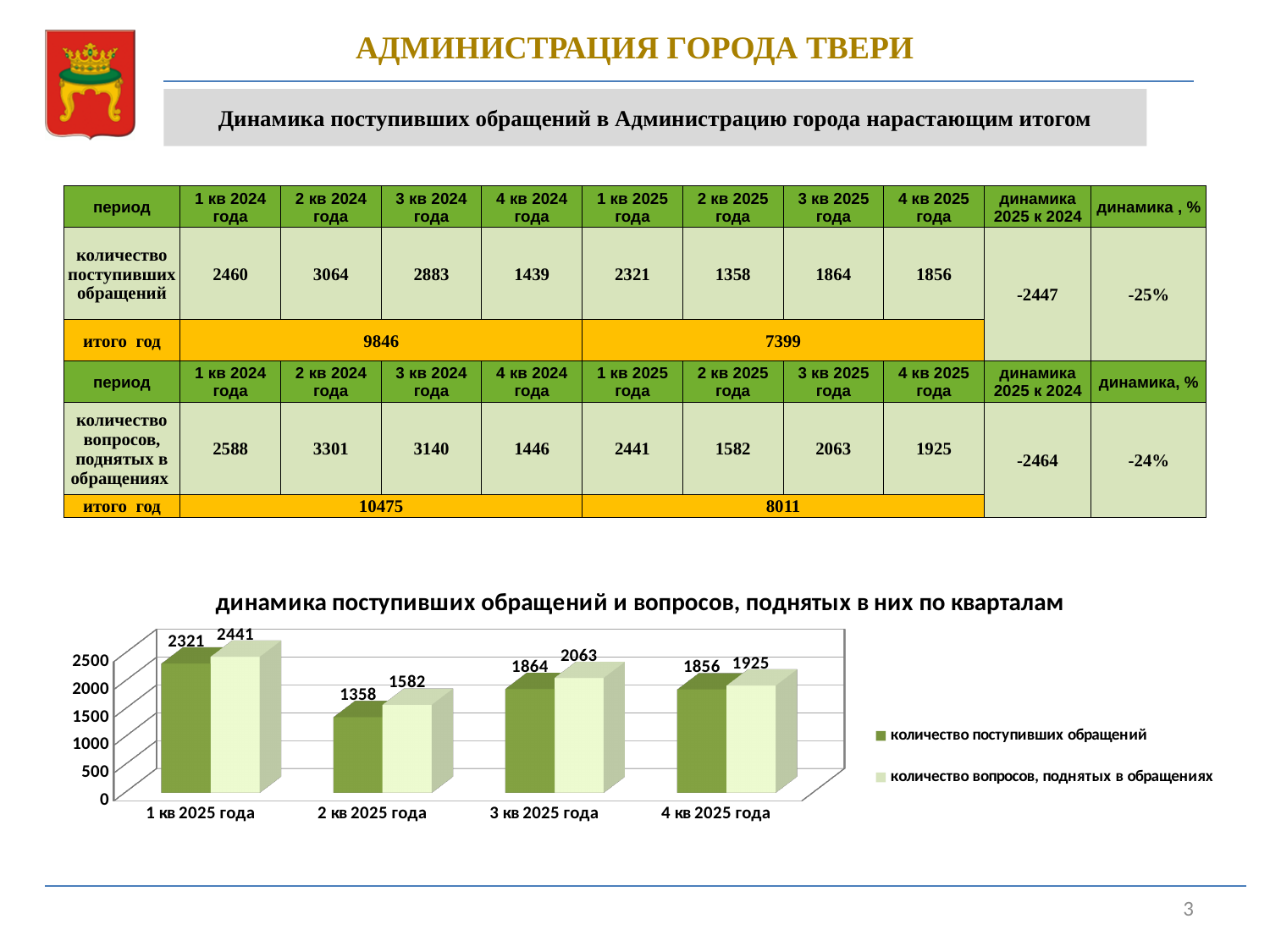
На сколько значение «количество вопросов, поднятых в обращениях» превышает «количество поступивших обращений» во 2 кв 2025 года на диаграмме? 224 В каком квартале значение серии «количество поступивших обращений» на диаграмме наибольшее? 1 кв 2025 года Что больше на диаграмме: «количество поступивших обращений» за 3 кв 2025 года или за 4 кв 2025 года? 3 кв 2025 года Какое значение показано для серии «количество поступивших обращений» за 4 кв 2025 года на диаграмме? 1856 Какого типа диаграмма на слайде? столбчатая (bar chart) Сколько серий перечислено в легенде диаграммы? 2 Какое значение показано для серии «количество поступивших обращений» за 1 кв 2025 года на диаграмме? 2321 В каком квартале значение серии «количество вопросов, поднятых в обращениях» на диаграмме наименьшее? 2 кв 2025 года Сколько кварталов показано по оси X на диаграмме? 4 Значение «количество поступивших обращений» за 2 кв 2025 года на диаграмме больше или меньше 1500? меньше Как называется диаграмма на слайде? динамика поступивших обращений и вопросов, поднятых в них по кварталам Какое значение показано для серии «количество вопросов, поднятых в обращениях» за 3 кв 2025 года на диаграмме? 2063